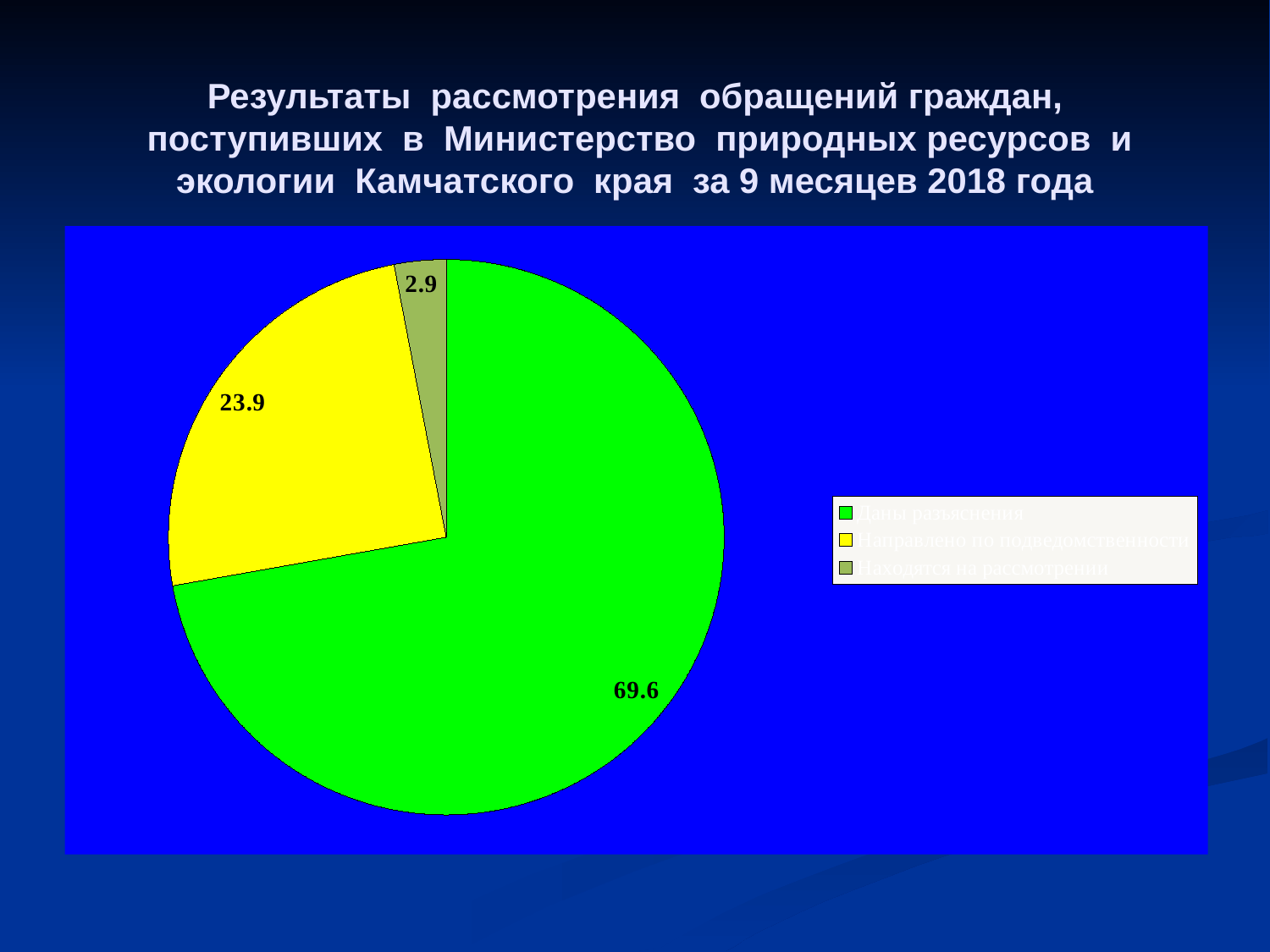
What is the value of the slice labelled "Направлено по подведомственности"? 23.9 How many slices does the pie chart have? 3 Which is larger: the value for "Направлено по подведомственности" or the value for "Находятся на рассмотрении"? Направлено по подведомственности What kind of chart is shown on the slide? Pie chart What is the difference between the values for "Даны разъяснения" and "Направлено по подведомственности"? 45.7 Which category has the smallest slice of the pie? Находятся на рассмотрении What is the value of the slice labelled "Даны разъяснения"? 69.6 Which category has the largest slice of the pie? Даны разъяснения How many entries does the legend list? 3 What is the value of the slice labelled "Находятся на рассмотрении"? 2.9 What colour is the slice for "Направлено по подведомственности"? Yellow What is the difference between the values for "Направлено по подведомственности" and "Находятся на рассмотрении"? 21.0